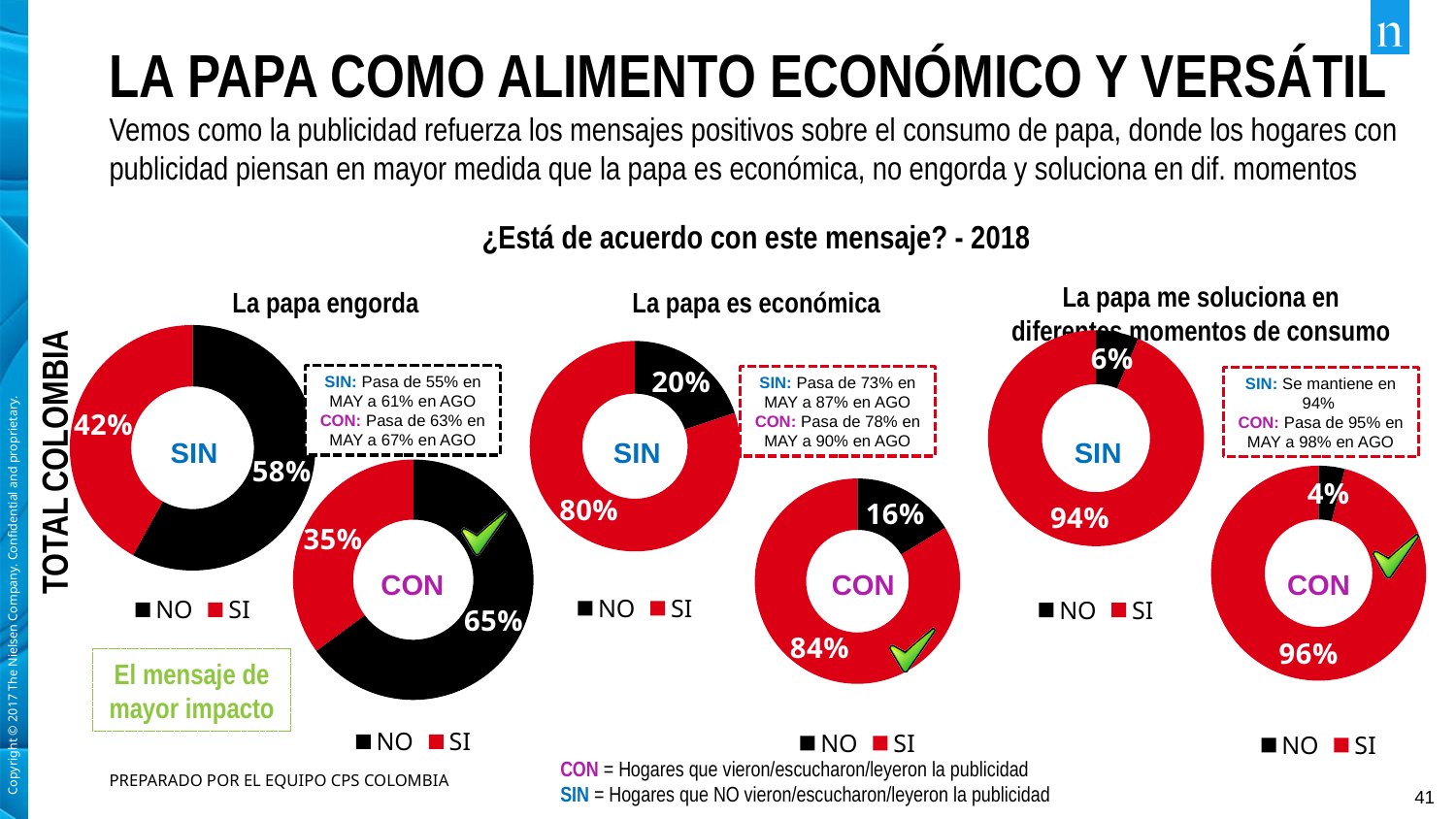
How many entries does the legend of the 'La papa engorda' SIN chart list? 2 In the 'La papa es económica' CON donut chart, what percentage answered NO? 16% What type of chart is used to show the responses for 'La papa es económica'? Donut (pie) chart In the 'La papa engorda' SIN donut chart, which response has the larger share, NO or SI? NO In the 'La papa me soluciona en diferentes momentos de consumo' SIN donut chart, what percentage answered SI? 94% What is the difference between the SI share in the 'La papa es económica' CON chart and the SI share in the 'La papa es económica' SIN chart? 4% In the 'La papa me soluciona en diferentes momentos de consumo' CON donut chart, what percentage answered NO? 4% In the 'La papa engorda' CON donut chart, what percentage answered NO? 65% In the donut charts on this slide, which colour represents the SI response? Red What is the difference between the NO share in the 'La papa engorda' CON chart and the NO share in the 'La papa engorda' SIN chart? 7% In the 'La papa es económica' SIN donut chart, what percentage answered SI? 80% In the 'La papa engorda' SIN donut chart, what percentage answered SI? 42%